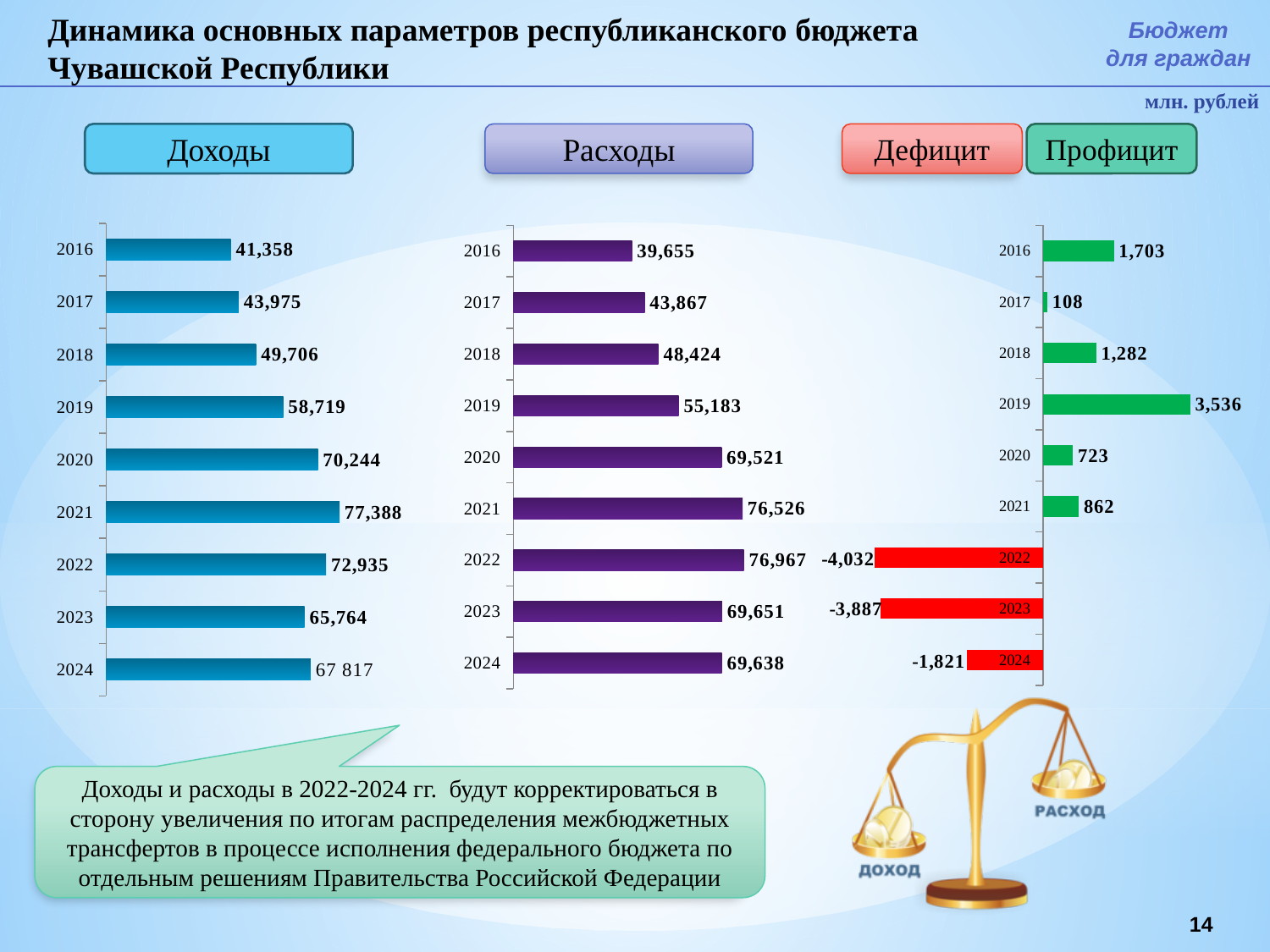
For 2022, which is larger: the value on the Доходы chart or the value on the Расходы chart? Расходы On the Расходы chart, what is the difference between the values for 2019 and 2018? 6,759 On the Дефицит/Профицит chart, what is the value for 2024? -1,821 How many years are shown on the Доходы chart? 9 On the Доходы chart, which year has the highest value? 2021 On the Доходы chart, what is the value for 2019? 58,719 On the Расходы chart, what is the value for 2022? 76,967 On the Дефицит/Профицит chart, what is the value for 2019? 3,536 On the Доходы chart, what is the difference between the values for 2021 and 2020? 7,144 On the Дефицит/Профицит chart, which year has the lowest value? 2022 On the Доходы chart, do the values rise or fall from 2016 to 2021? rise What kind of chart is the Расходы chart? bar chart